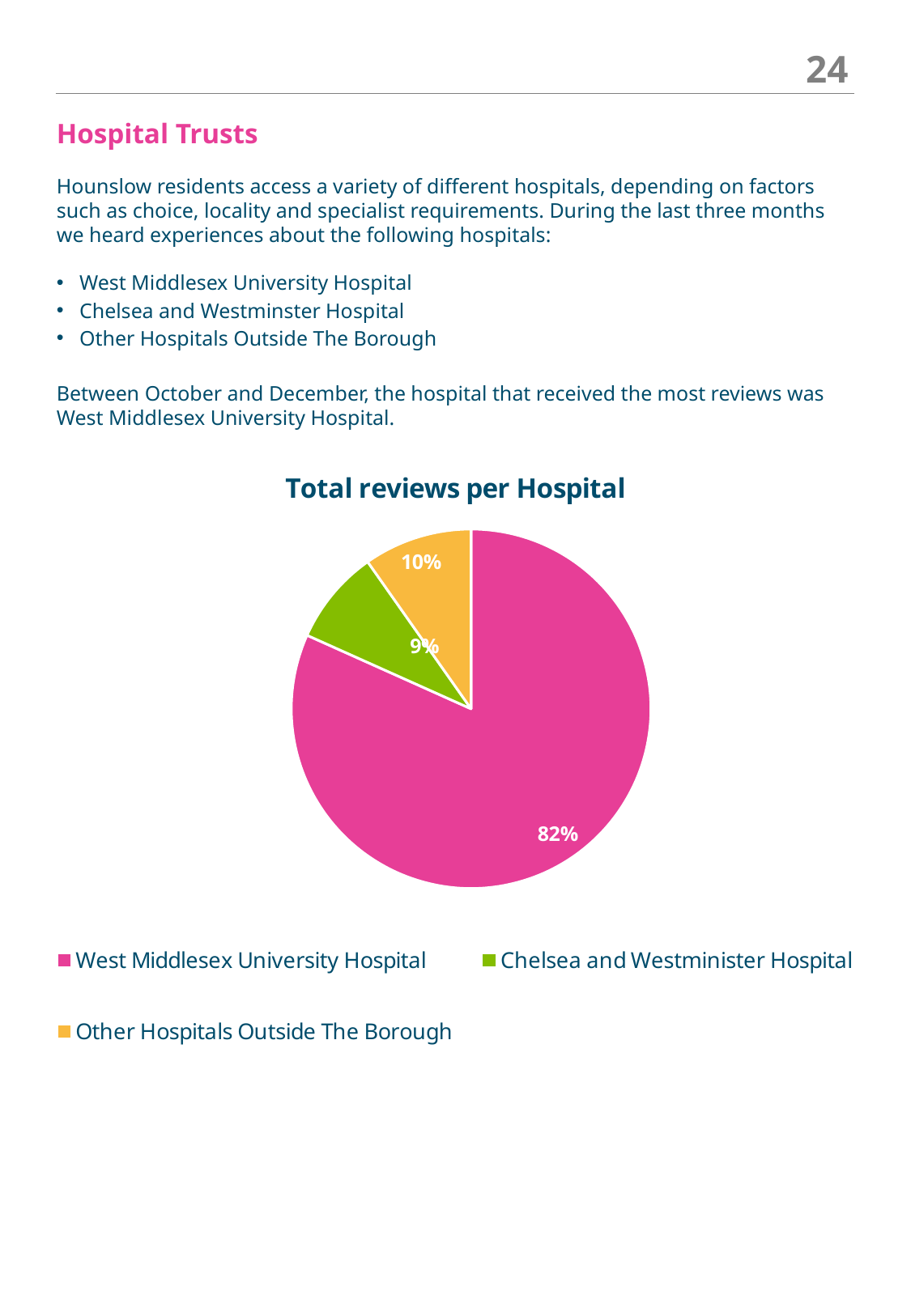
Which hospital has the largest share of reviews? West Middlesex University Hospital What colour is the slice for West Middlesex University Hospital? Pink What share of total reviews does West Middlesex University Hospital have? 82% What is the difference in percentage points between West Middlesex University Hospital and Other Hospitals Outside The Borough? 72 What kind of chart is shown on the slide? Pie chart What share of total reviews do Other Hospitals Outside The Borough have? 10% How many slices does the pie chart have? 3 What is the title of the chart? Total reviews per Hospital Which hospital has the smallest share of reviews? Chelsea and Westminister Hospital What share of total reviews does Chelsea and Westminister Hospital have? 9% How many entries does the legend list? 3 Which has a larger share of reviews, Chelsea and Westminister Hospital or Other Hospitals Outside The Borough? Other Hospitals Outside The Borough